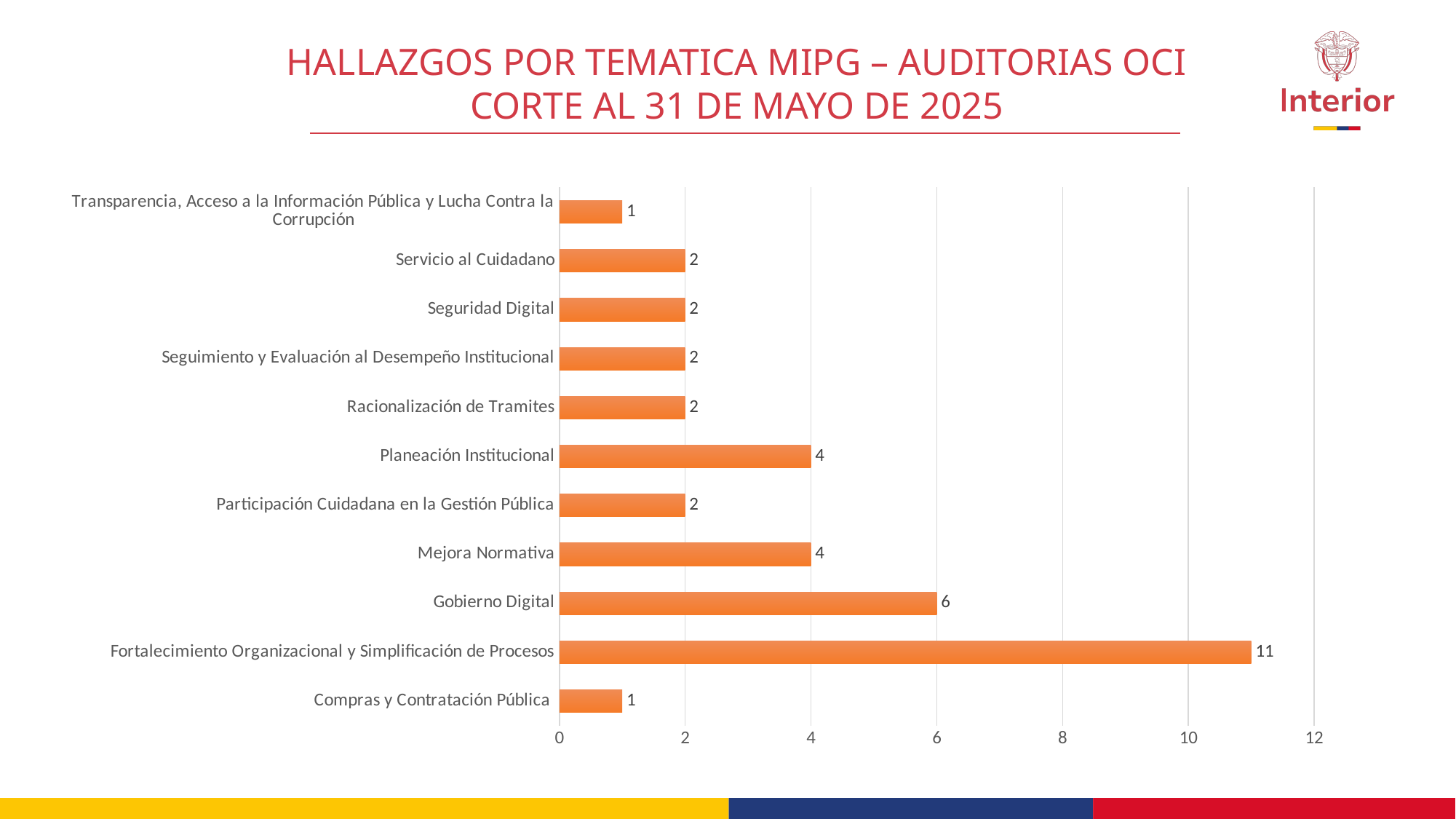
What is the difference between the values for Fortalecimiento Organizacional y Simplificación de Procesos and Gobierno Digital? 5 Is the value for Gobierno Digital greater or less than 4? greater What kind of chart is shown on the slide? Bar chart What is the title of the chart on the slide? HALLAZGOS POR TEMATICA MIPG – AUDITORIAS OCI CORTE AL 31 DE MAYO DE 2025 How many categories are shown in the chart? 11 What is the value for Compras y Contratación Pública? 1 What is the value for Fortalecimiento Organizacional y Simplificación de Procesos? 11 Which category has the highest value? Fortalecimiento Organizacional y Simplificación de Procesos What is the value for Planeación Institucional? 4 Which is larger, the value for Mejora Normativa or the value for Seguridad Digital? Mejora Normativa What is the value for Gobierno Digital? 6 What is the total of the values for Servicio al Cuidadano and Racionalización de Tramites? 4